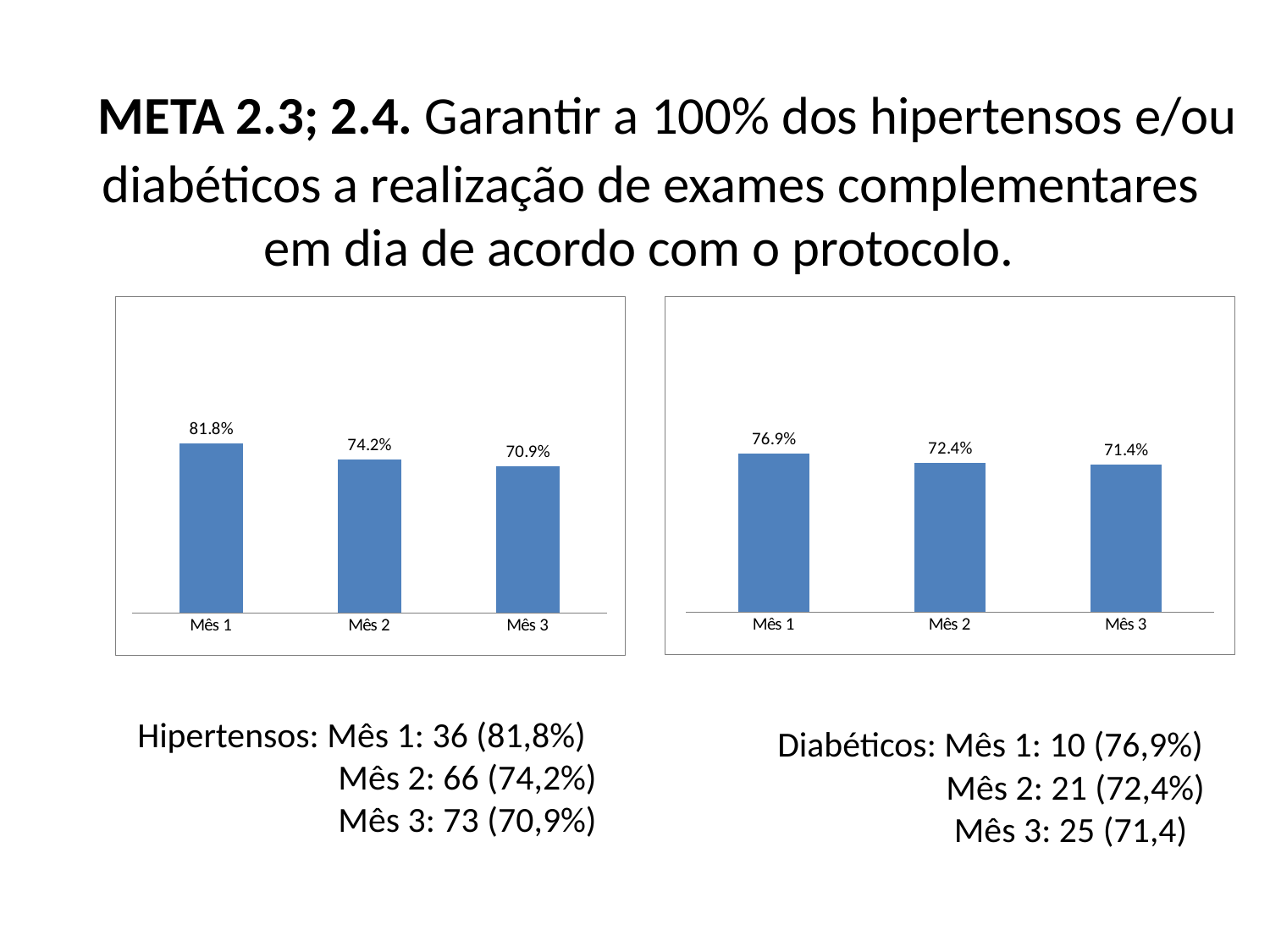
What type of chart is the right chart? Bar chart In the left chart, do the values rise or fall from Mês 1 to Mês 3? Fall In the right chart, what is the value for Mês 2? 72.4% In the right chart, which month has the lowest value? Mês 3 How many bars are plotted in the left chart? 3 In the left chart, what is the value for Mês 3? 70.9% In the left chart, what is the difference between the values for Mês 1 and Mês 2? 7.6 percentage points In the left chart, which month has the highest value? Mês 1 In the right chart, which is larger, the value for Mês 2 or the value for Mês 3? Mês 2 In the left chart, what is the value for Mês 1? 81.8% In the right chart, what is the value for Mês 1? 76.9% In the right chart, what is the difference between the values for Mês 1 and Mês 3? 5.5 percentage points